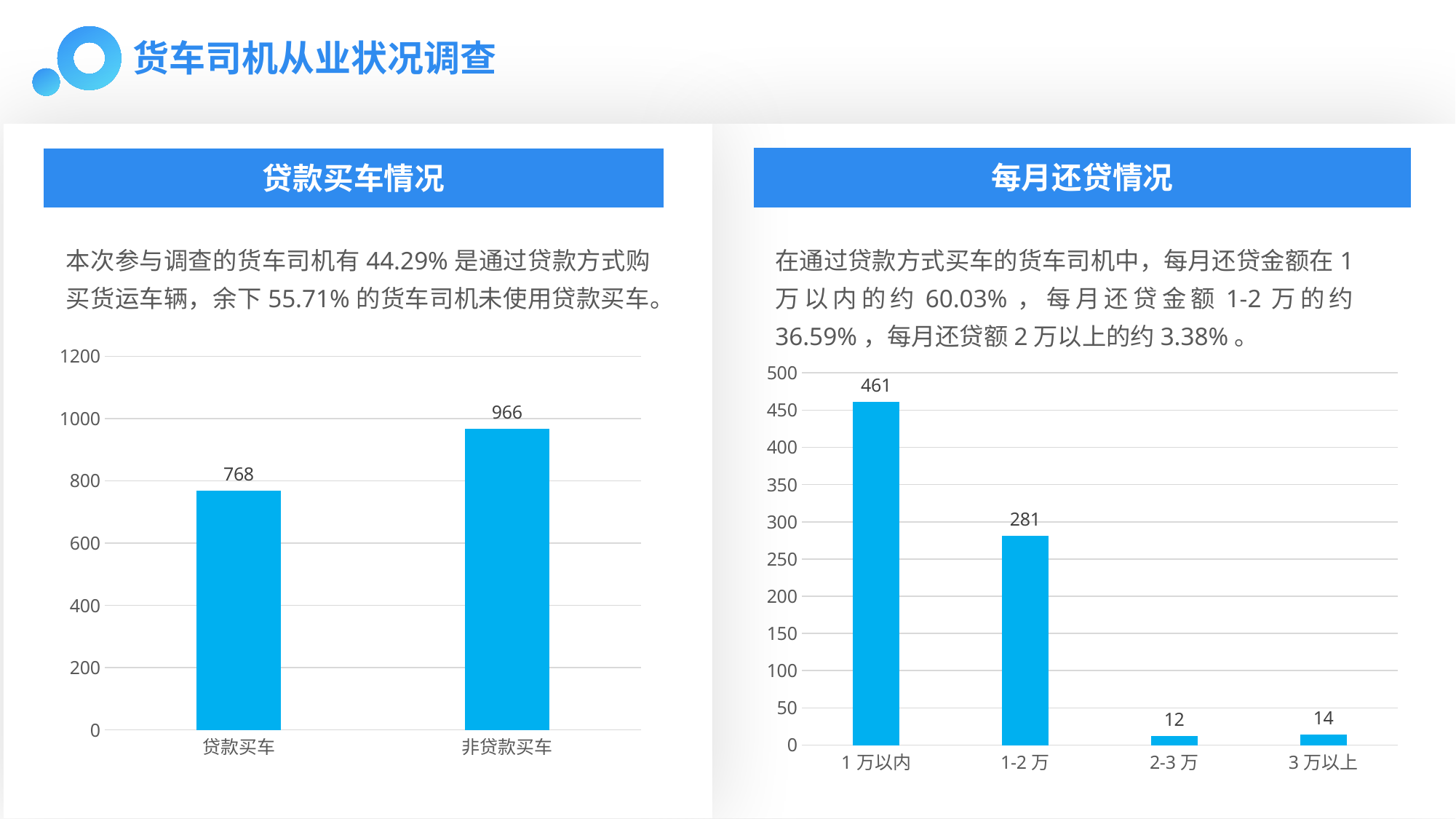
What kind of chart is the 每月还贷情况 chart on the right? bar chart In the 贷款买车情况 chart on the left, what is the value for 非贷款买车? 966 In the 每月还贷情况 chart on the right, how many categories are shown? 4 In the 贷款买车情况 chart on the left, how many categories are shown? 2 In the 贷款买车情况 chart on the left, what is the value for 贷款买车? 768 In the 每月还贷情况 chart on the right, which category has the lowest value? 2-3 万 In the 贷款买车情况 chart on the left, which category has the higher value? 非贷款买车 In the 每月还贷情况 chart on the right, is the value for 1-2 万 greater or less than 300? less In the 每月还贷情况 chart on the right, what is the value for 1 万以内? 461 In the 每月还贷情况 chart on the right, what is the difference between 1 万以内 and 1-2 万? 180 In the 贷款买车情况 chart on the left, what is the difference between 非贷款买车 and 贷款买车? 198 In the 每月还贷情况 chart on the right, what is the value for 1-2 万? 281